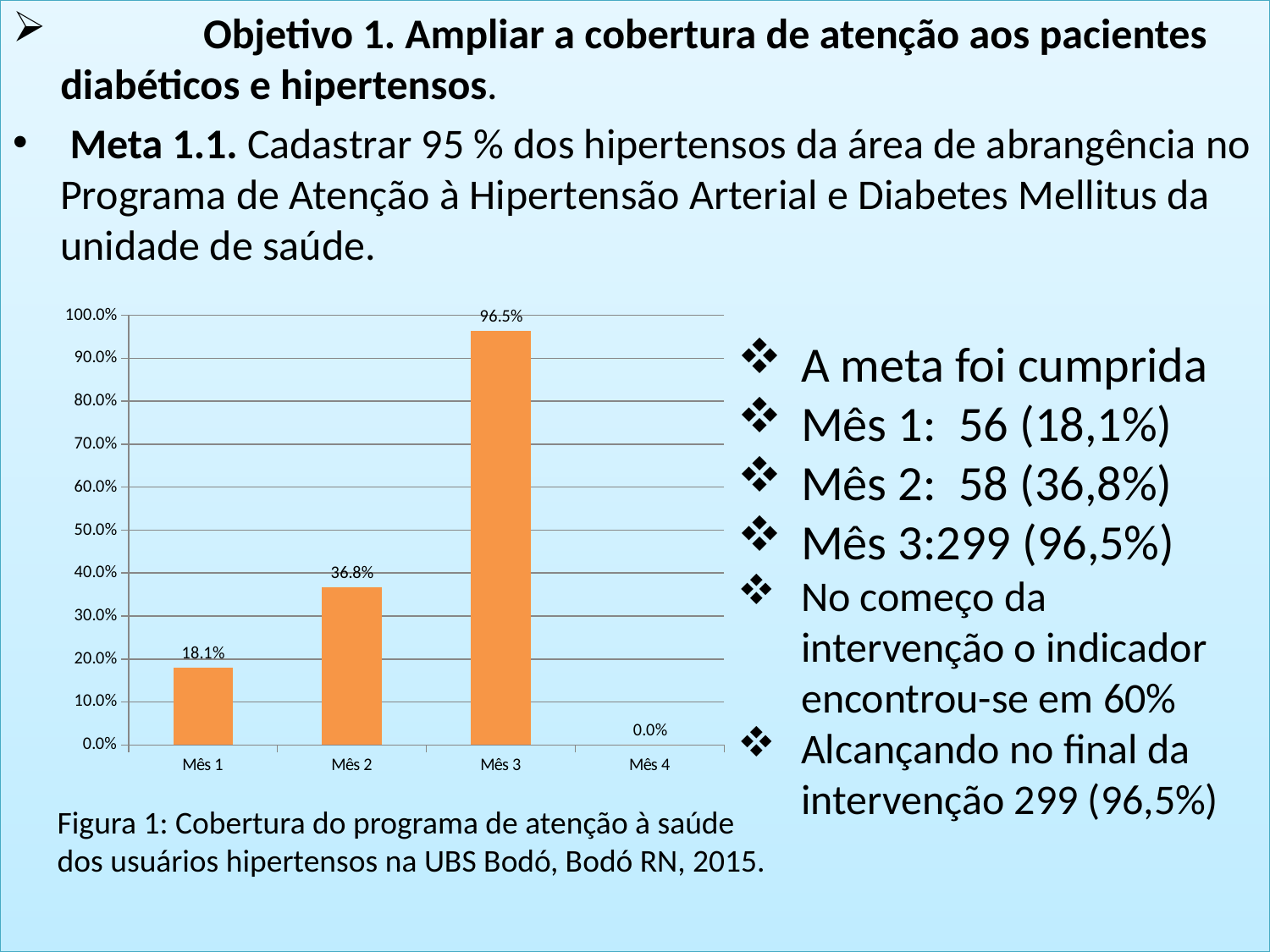
Do the values rise or fall from Mês 1 to Mês 3? Rise What is the value for Mês 3? 96.5% What is the value for Mês 2? 36.8% What is the value for Mês 4? 0.0% How many months are shown on the x axis? 4 What is the difference between the values for Mês 2 and Mês 1? 18.7% What kind of chart is shown? Bar chart Which is larger, the value for Mês 1 or Mês 2? Mês 2 What is the difference between the values for Mês 3 and Mês 2? 59.7% Which month has the highest value? Mês 3 What is the value for Mês 1? 18.1% Which month has the lowest value? Mês 4